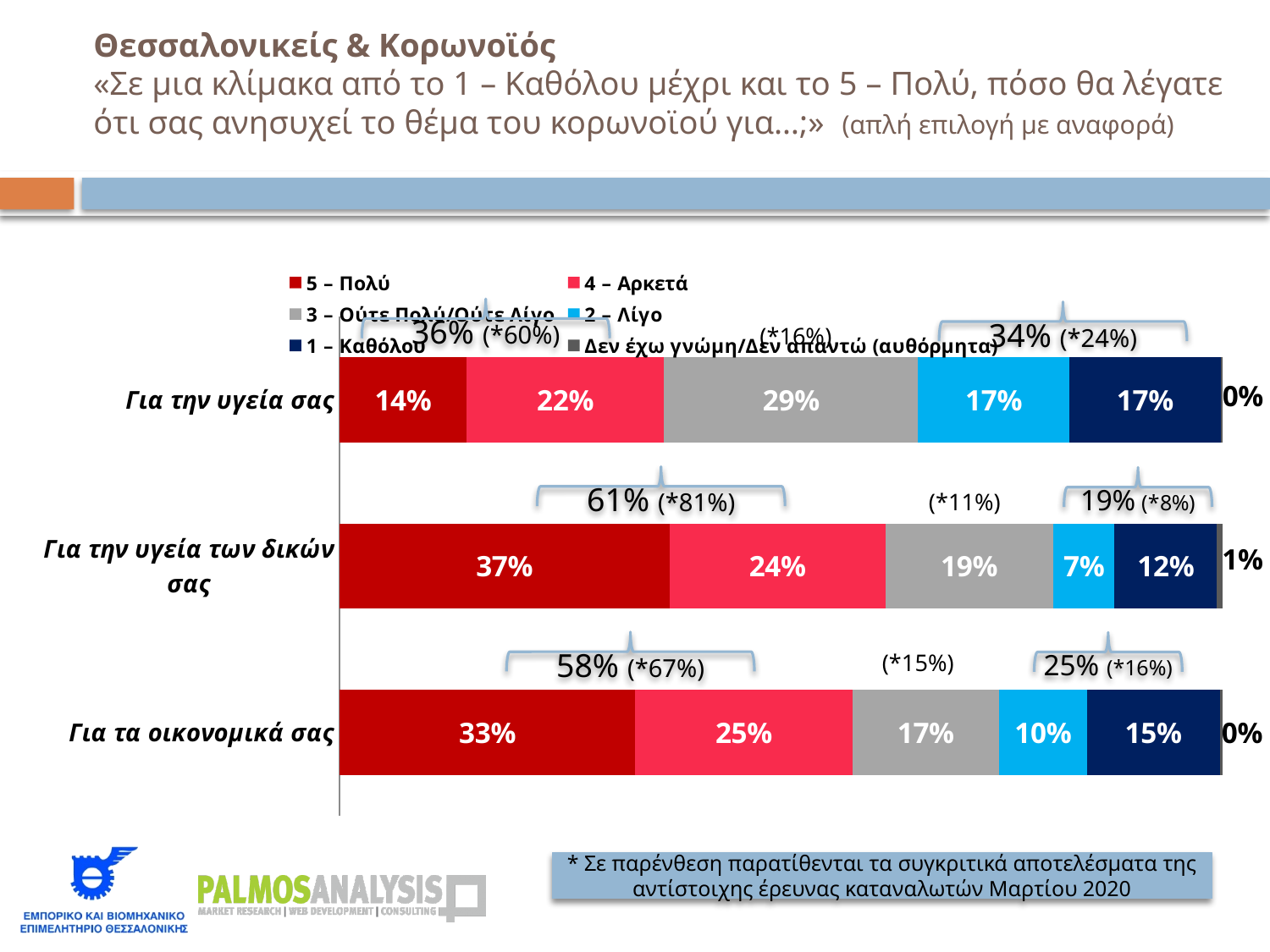
What colour represents the "1 – Καθόλου" series in the chart? Dark navy blue What is the value of "5 – Πολύ" for "Για την υγεία των δικών σας"? 37% Which category has the lowest value for "2 – Λίγο"? Για την υγεία των δικών σας Which is larger: the "4 – Αρκετά" value for "Για τα οικονομικά σας" or for "Για την υγεία σας"? Για τα οικονομικά σας How many series does the legend list? 6 What is the value of "1 – Καθόλου" for "Για την υγεία των δικών σας"? 12% What is the value of "3 – Ούτε Πολύ/Ούτε Λίγο" for "Για την υγεία σας"? 29% What kind of chart is shown on the slide? Stacked bar chart How many categories are plotted on the chart? 3 Which category has the highest value for "5 – Πολύ"? Για την υγεία των δικών σας What is the value of "2 – Λίγο" for "Για τα οικονομικά σας"? 10% What is the difference between the "5 – Πολύ" values for "Για τα οικονομικά σας" and "Για την υγεία σας"? 19%